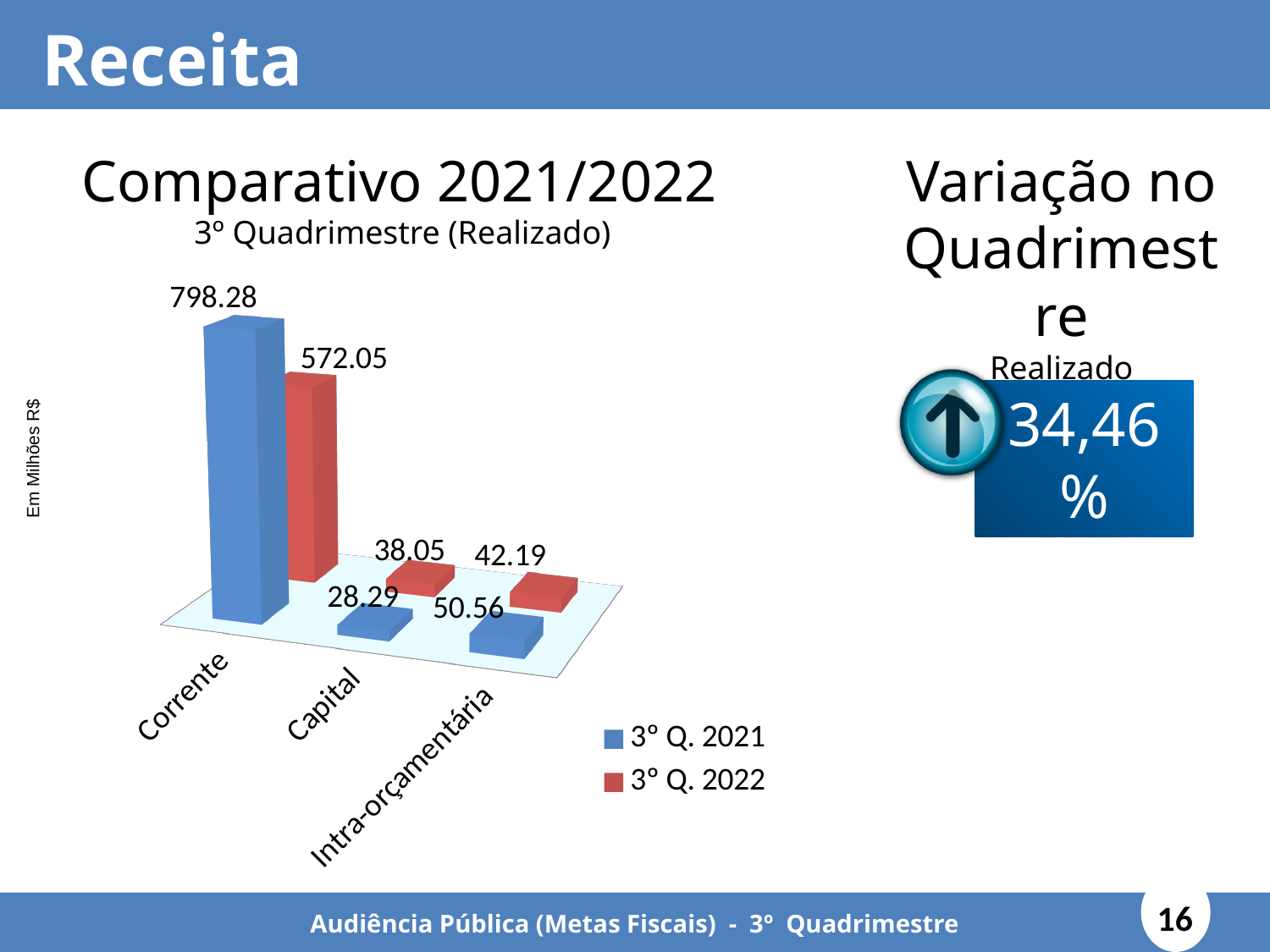
What is the difference between the 3º Q. 2021 and 3º Q. 2022 values for Corrente? 226.23 How many categories are shown on the x axis of the chart? 3 What is the value for Corrente in the 3º Q. 2022 series? 572.05 What type of chart is shown on the slide? Bar chart Which category has the highest value in the 3º Q. 2021 series? Corrente What is the difference between the 3º Q. 2022 and 3º Q. 2021 values for Capital? 9.76 For Intra-orçamentária, which series has the larger value, 3º Q. 2021 or 3º Q. 2022? 3º Q. 2021 What is the value for Corrente in the 3º Q. 2021 series? 798.28 How many series does the chart legend list? 2 What is the value for Intra-orçamentária in the 3º Q. 2021 series? 50.56 What is the value for Capital in the 3º Q. 2022 series? 38.05 Which category has the lowest value in the 3º Q. 2022 series? Capital